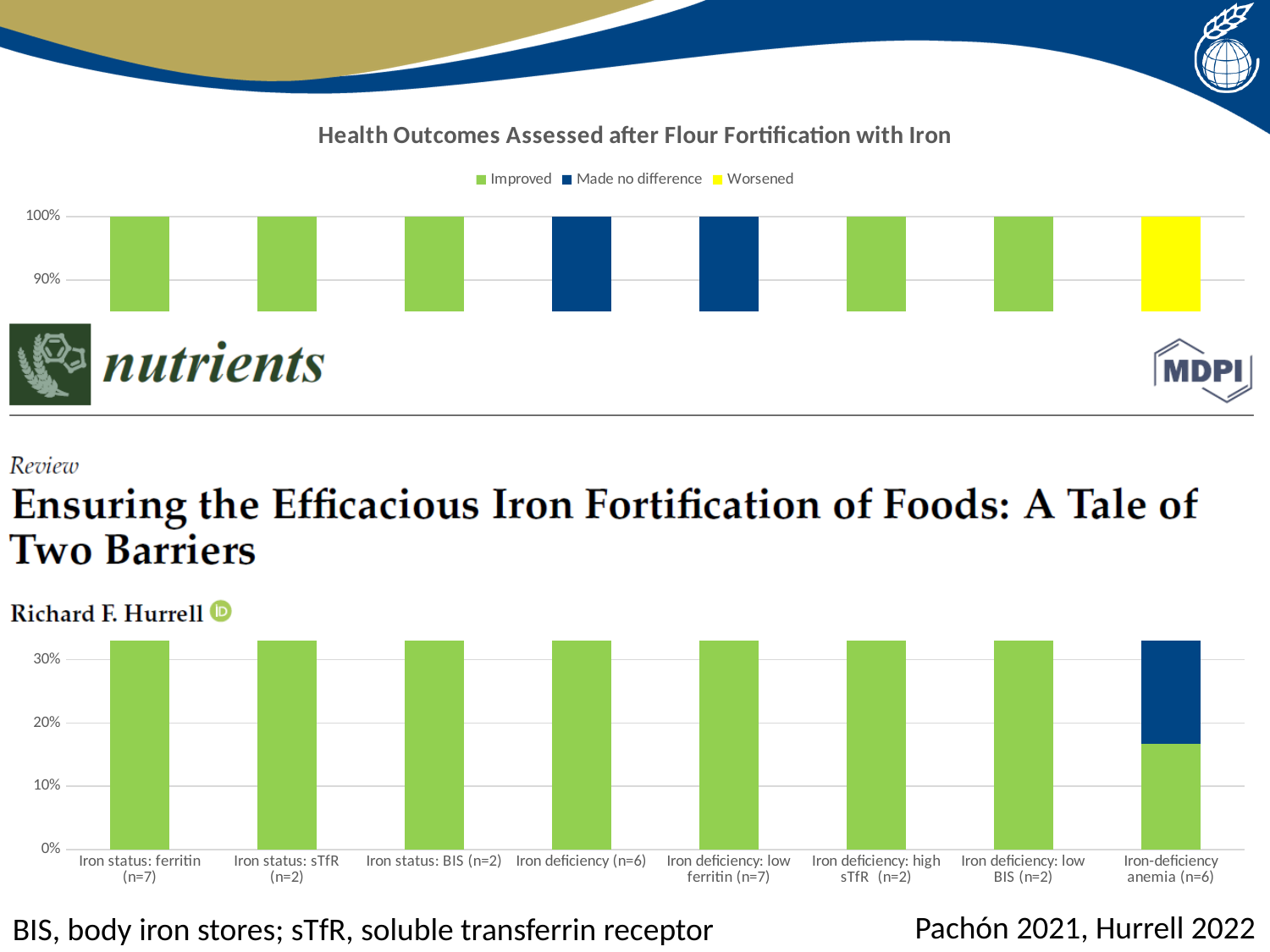
Which is larger for Iron-deficiency anemia (n=6): the Improved segment or the Made no difference segment? Made no difference How many categories are shown along the x axis of the chart? 8 Is the Improved value for Iron deficiency (n=6) greater or less than 90%? less Which category is the only one with a Worsened segment? Iron-deficiency anemia (n=6) How many series does the chart legend list? 3 What is the title of the chart? Health Outcomes Assessed after Flour Fortification with Iron Is the Improved value for Iron-deficiency anemia (n=6) greater or less than 20%? less Is the Improved value for Iron deficiency: low ferritin (n=7) greater or less than 30%? greater What kind of chart is shown on the slide? stacked bar chart Which colour represents the Worsened series in the chart? yellow Which series reaches the top of the bar for Iron deficiency: low ferritin (n=7)? Made no difference